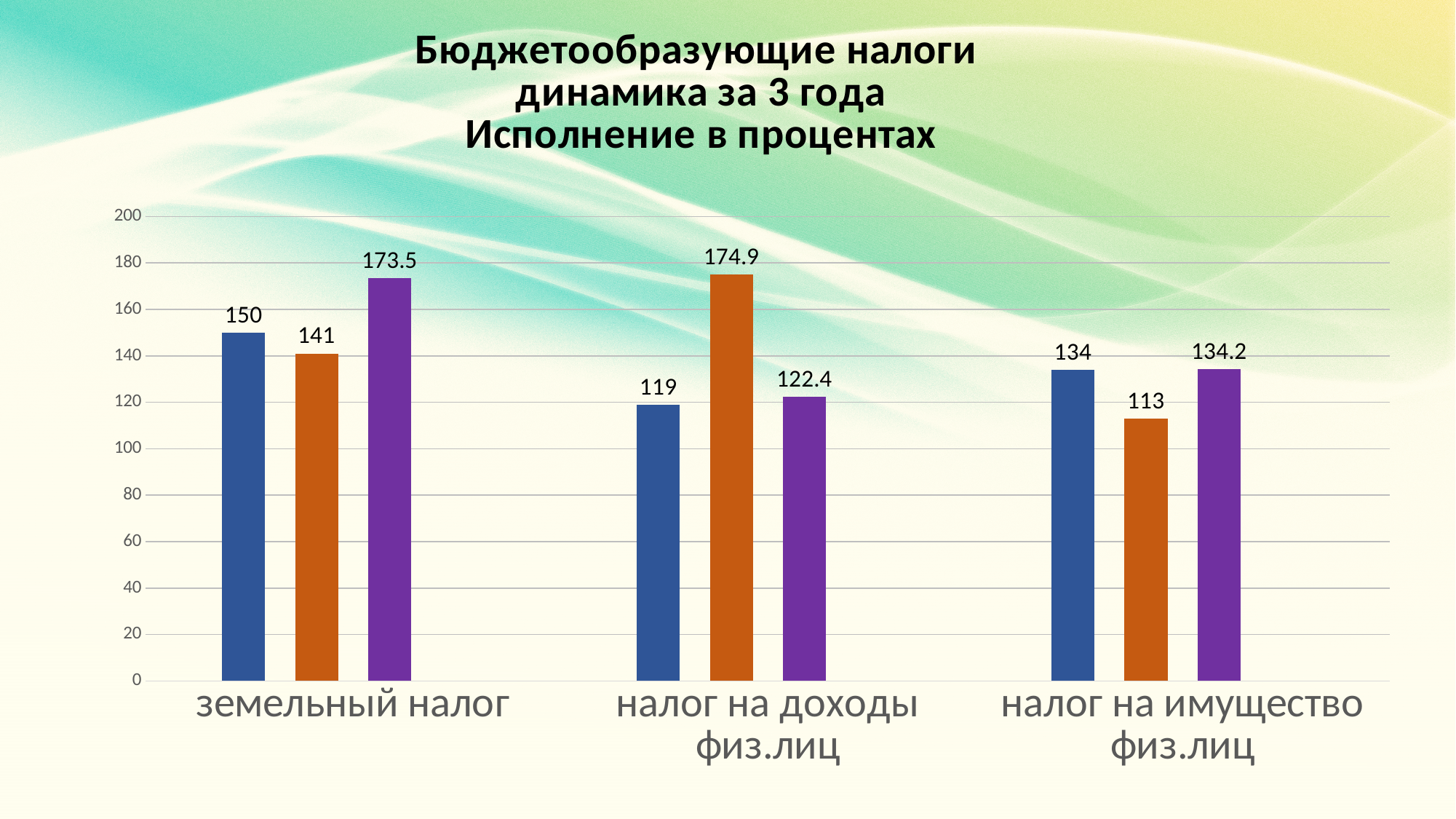
Which is larger for налог на доходы физ.лиц: the blue bar or the purple bar? the purple bar What is the title of the chart? Бюджетообразующие налоги динамика за 3 года Исполнение в процентах Which category has the highest blue bar? земельный налог How many categories are shown on the x axis? 3 What is the value of the orange bar for налог на имущество физ.лиц? 113 Which category has the lowest orange bar? налог на имущество физ.лиц What is the value of the orange bar for налог на доходы физ.лиц? 174.9 What is the difference between the purple bar and the blue bar for земельный налог? 23.5 What kind of chart is shown on the slide? bar chart What is the value of the purple bar for налог на имущество физ.лиц? 134.2 What is the difference between the orange bar and the blue bar for налог на доходы физ.лиц? 55.9 What is the value of the blue bar for земельный налог? 150